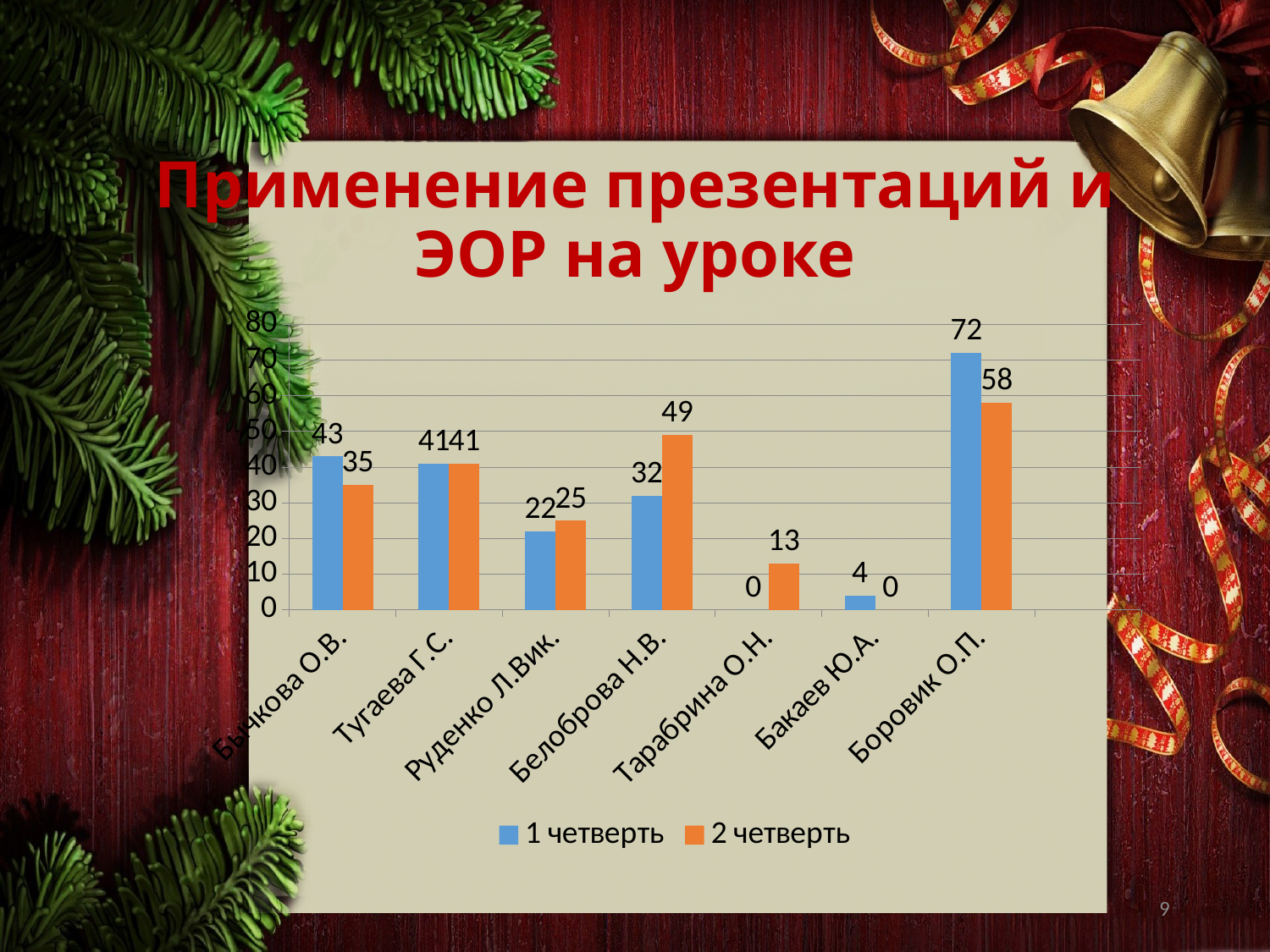
Which category has the highest value in the 1 четверть series? Боровик О.П. How many series does the legend list? 2 What is the value for Тарабрина О.Н. in the 1 четверть series? 0 How many categories are shown on the x axis? 7 Which is larger for Белоброва Н.В.: the 1 четверть value or the 2 четверть value? 2 четверть Which category has the lowest value in the 2 четверть series? Бакаев Ю.А. What is the value for Белоброва Н.В. in the 2 четверть series? 49 Is the 1 четверть value for Боровик О.П. greater or less than 60? greater What is the title of the slide containing the chart? Применение презентаций и ЭОР на уроке What kind of chart is shown on the slide? bar chart What is the difference between the 1 четверть and 2 четверть values for Боровик О.П.? 14 What is the value for Бычкова О.В. in the 1 четверть series? 43